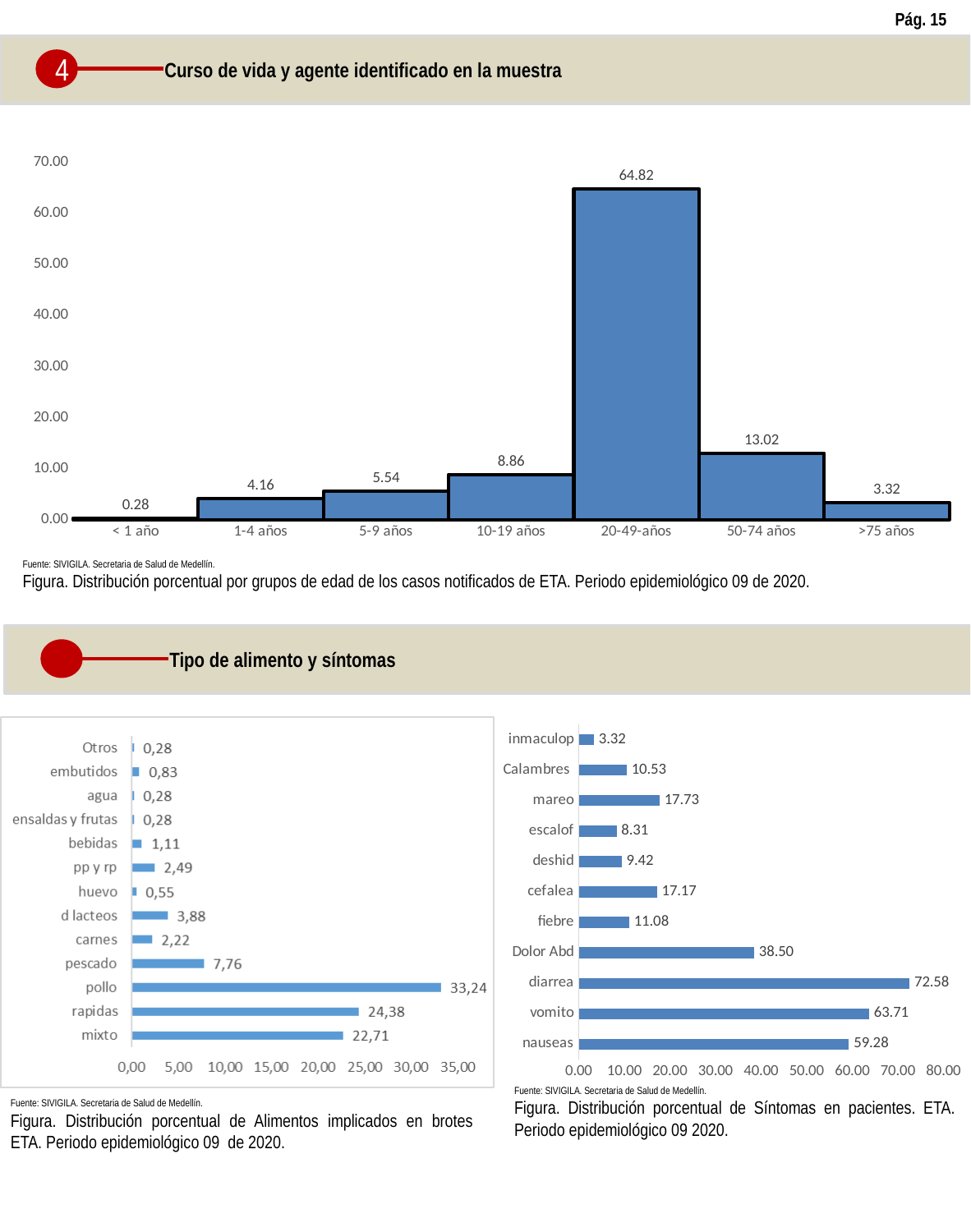
In the bottom-right chart (symptoms in ETA patients), which symptom has the highest value? diarrea In the bottom-right chart (symptoms in ETA patients), what is the difference between the values for diarrea and vomito? 8.87 In the top chart (age groups of ETA cases), how many age groups are shown? 7 In the bottom-left chart (foods implicated in ETA outbreaks), which is larger, rapidas or mixto? rapidas In the bottom-left chart (foods implicated in ETA outbreaks), what is the value for pollo? 33,24 In the top chart (age groups of ETA cases), what is the value for 20-49-años? 64.82 In the top chart (age groups of ETA cases), what kind of chart is it? Bar chart In the bottom-left chart (foods implicated in ETA outbreaks), how many food categories are listed? 13 In the top chart (age groups of ETA cases), what is the difference between the values for 50-74 años and 10-19 años? 4.16 In the bottom-right chart (symptoms in ETA patients), what is the value for Dolor Abd? 38.50 In the bottom-right chart (symptoms in ETA patients), how many symptoms are listed? 11 In the top chart (age groups of ETA cases), which age group has the lowest value? < 1 año